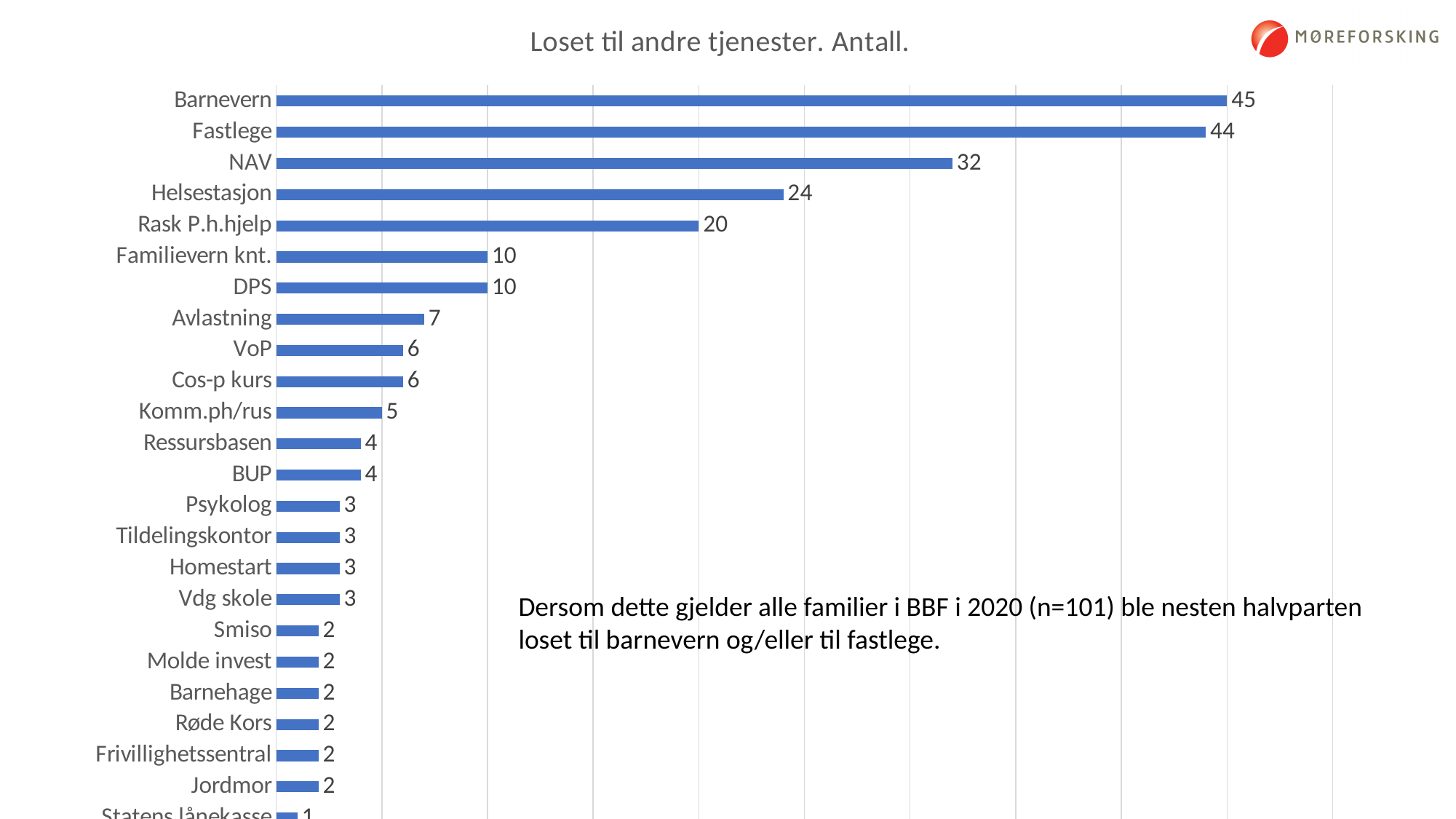
What is the value for Barnevern? 45 Which category has the highest value? Barnevern What kind of chart is shown on the slide? Bar chart What is the value for Komm.ph/rus? 5 What is the difference between the values for NAV and Helsestasjon? 8 What is the difference between the values for Barnevern and Fastlege? 1 What is the value for Avlastning? 7 Which is larger, the value for Rask P.h.hjelp or the value for DPS? Rask P.h.hjelp What is the value for NAV? 32 What is the value for Helsestasjon? 24 What is the title of the chart? Loset til andre tjenester. Antall. What is the value for Rask P.h.hjelp? 20